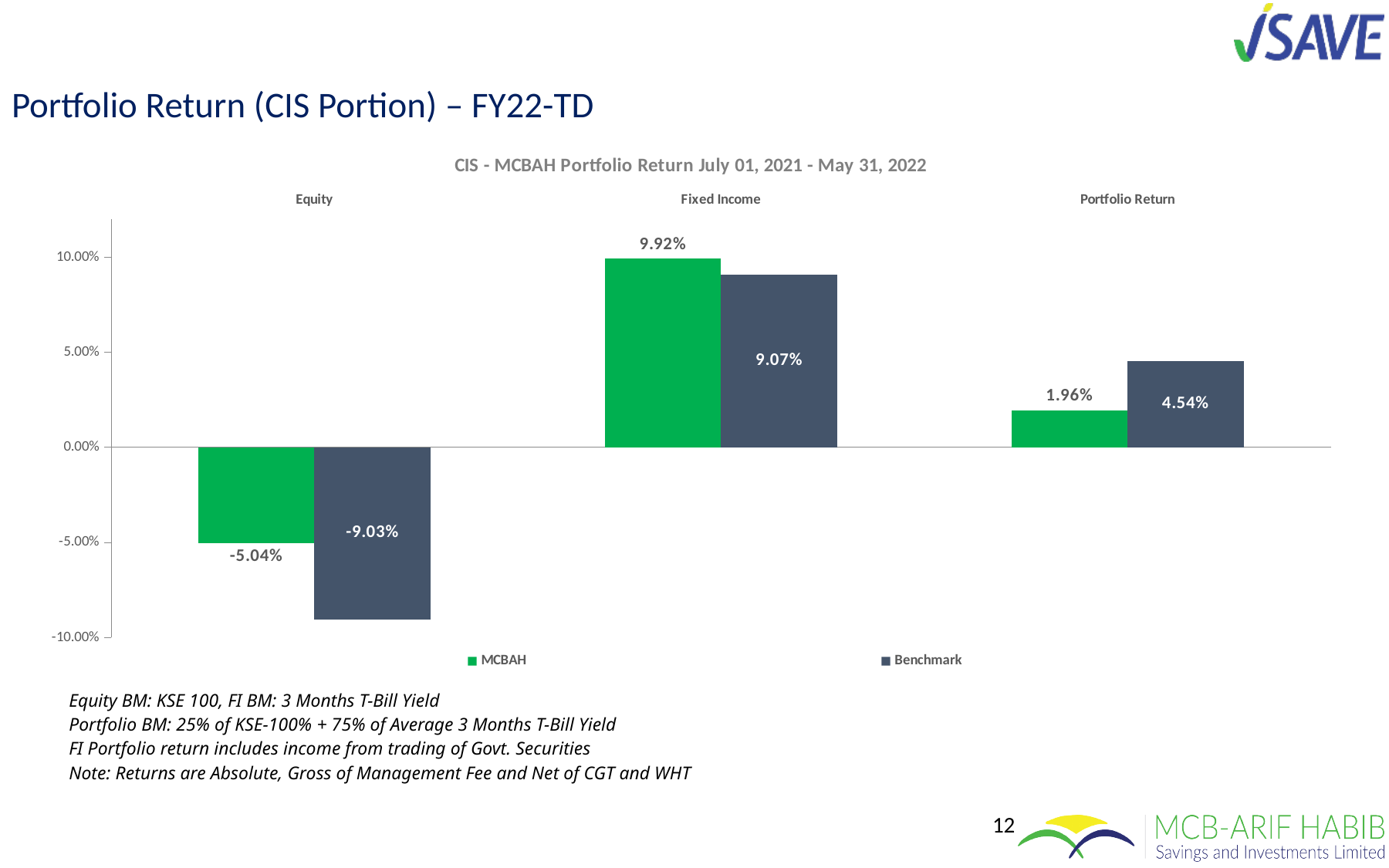
How many categories are shown on the x axis? 3 What is the Benchmark value for Portfolio Return? 4.54% What is the difference between the MCBAH and Benchmark returns for Fixed Income? 0.85% What is the MCBAH value for Portfolio Return? 1.96% For Equity, which is larger, the MCBAH return or the Benchmark return? MCBAH Which category has the lowest Benchmark return? Equity How many series does the legend list? 2 What is the difference between the Benchmark and MCBAH values for Portfolio Return? 2.58% What type of chart is shown on the slide? Bar chart What is the MCBAH return for Fixed Income? 9.92% Which category has the highest MCBAH return? Fixed Income What is the Benchmark return for Equity? -9.03%